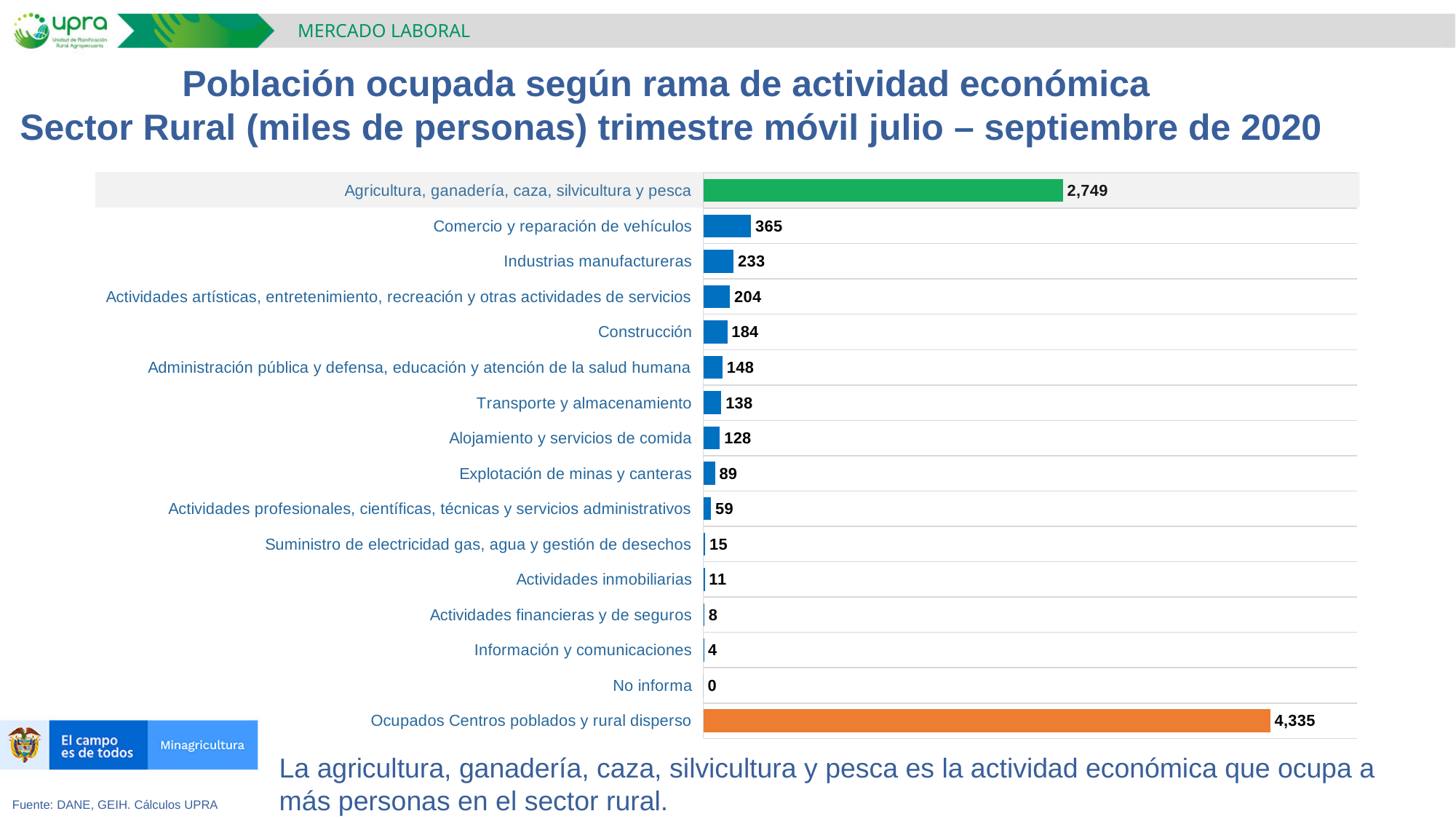
Which category has the lowest value? No informa What is the value for Construcción? 184 What colour is the bar for Ocupados Centros poblados y rural disperso? Orange What is the difference between Agricultura, ganadería, caza, silvicultura y pesca and Comercio y reparación de vehículos? 2,384 How many bars are shown in the chart? 16 What is the value for Ocupados Centros poblados y rural disperso? 4,335 What is the value for Comercio y reparación de vehículos? 365 What is the difference between Industrias manufactureras and Construcción? 49 What is the value for Explotación de minas y canteras? 89 What type of chart is shown on the slide? Bar chart Which is larger, Transporte y almacenamiento or Alojamiento y servicios de comida? Transporte y almacenamiento Which economic activity (excluding the total bar) has the highest value? Agricultura, ganadería, caza, silvicultura y pesca